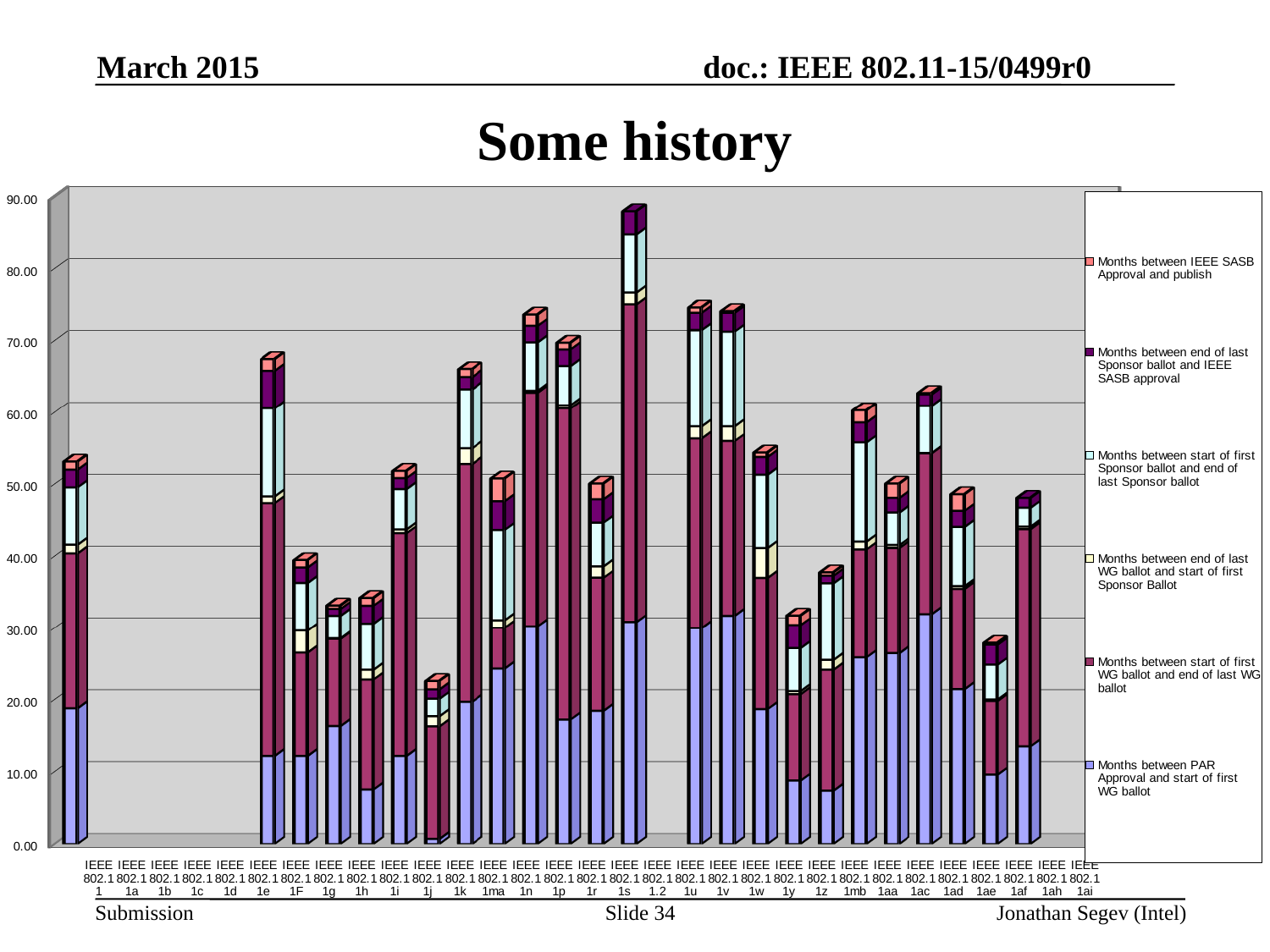
What is the title of the chart? Some history Which series is listed last (at the bottom) in the legend? Months between PAR Approval and start of first WG ballot Is the total for IEEE 802.11e greater or less than 60? greater Is the total for IEEE 802.11n greater or less than 70? greater Is the total for IEEE 802.11ae greater or less than 40? less Which has the taller stacked bar, IEEE 802.11s or IEEE 802.11n? IEEE 802.11s What kind of chart is shown on the slide? Stacked bar chart How many series does the legend list? 6 Which category has the tallest stacked bar? IEEE 802.11s Which has the taller stacked bar, IEEE 802.11e or IEEE 802.11g? IEEE 802.11e